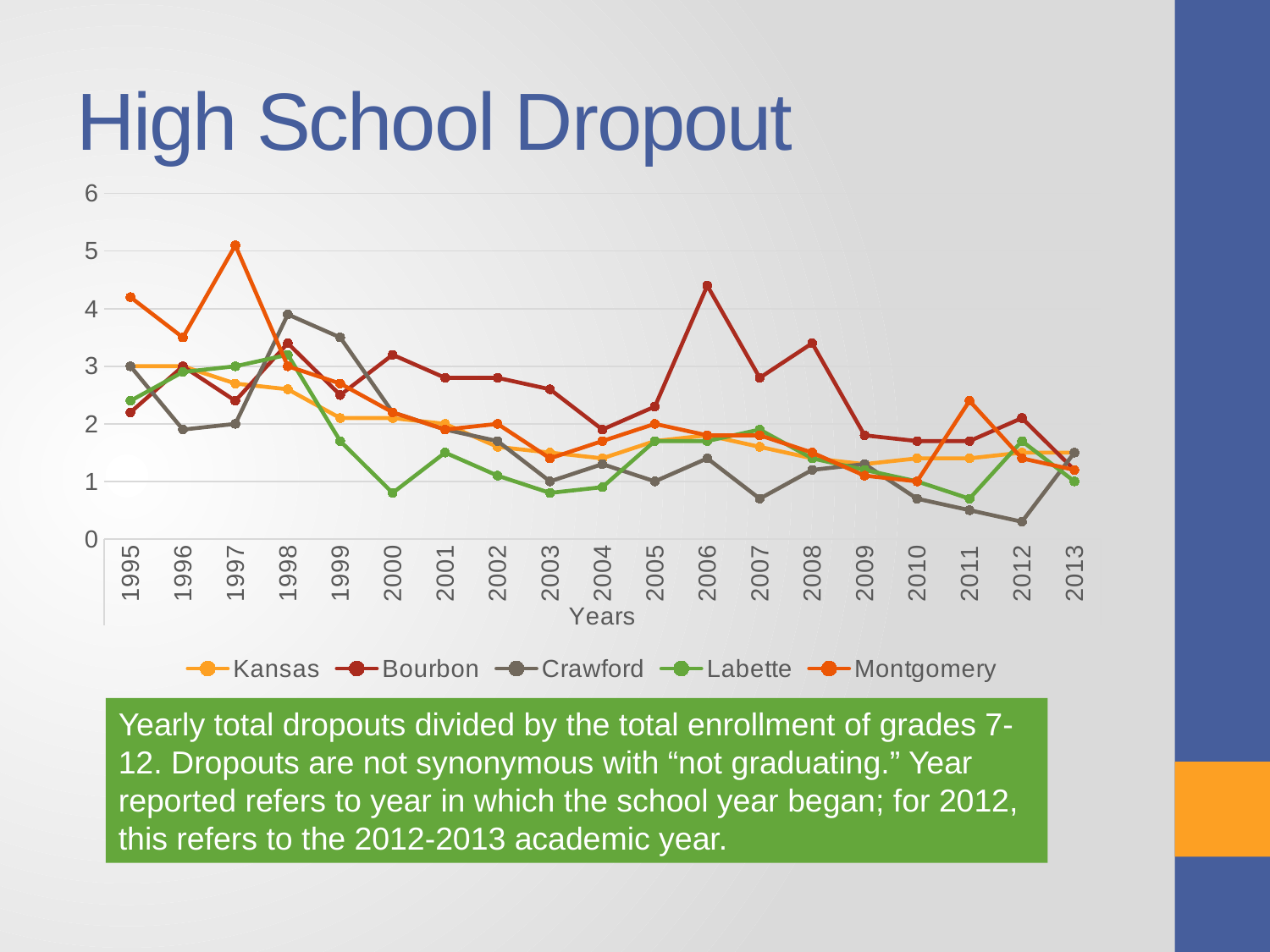
What is the title of the x axis? Years Is the value for Crawford in 2012 greater or less than 1? less Is the value for Bourbon in 2006 greater or less than 4? greater Which series has the highest value in 1998? Crawford How many years are plotted along the x axis? 19 How many series does the legend list? 5 Which series has the lowest value in 2012? Crawford Which series has the highest value in 2006? Bourbon In 2007, which is larger: the value for Bourbon or the value for Crawford? Bourbon What kind of chart is shown on the slide? line chart Which series has the highest value in 1997? Montgomery Is the value for Crawford in 1998 greater or less than 3? greater